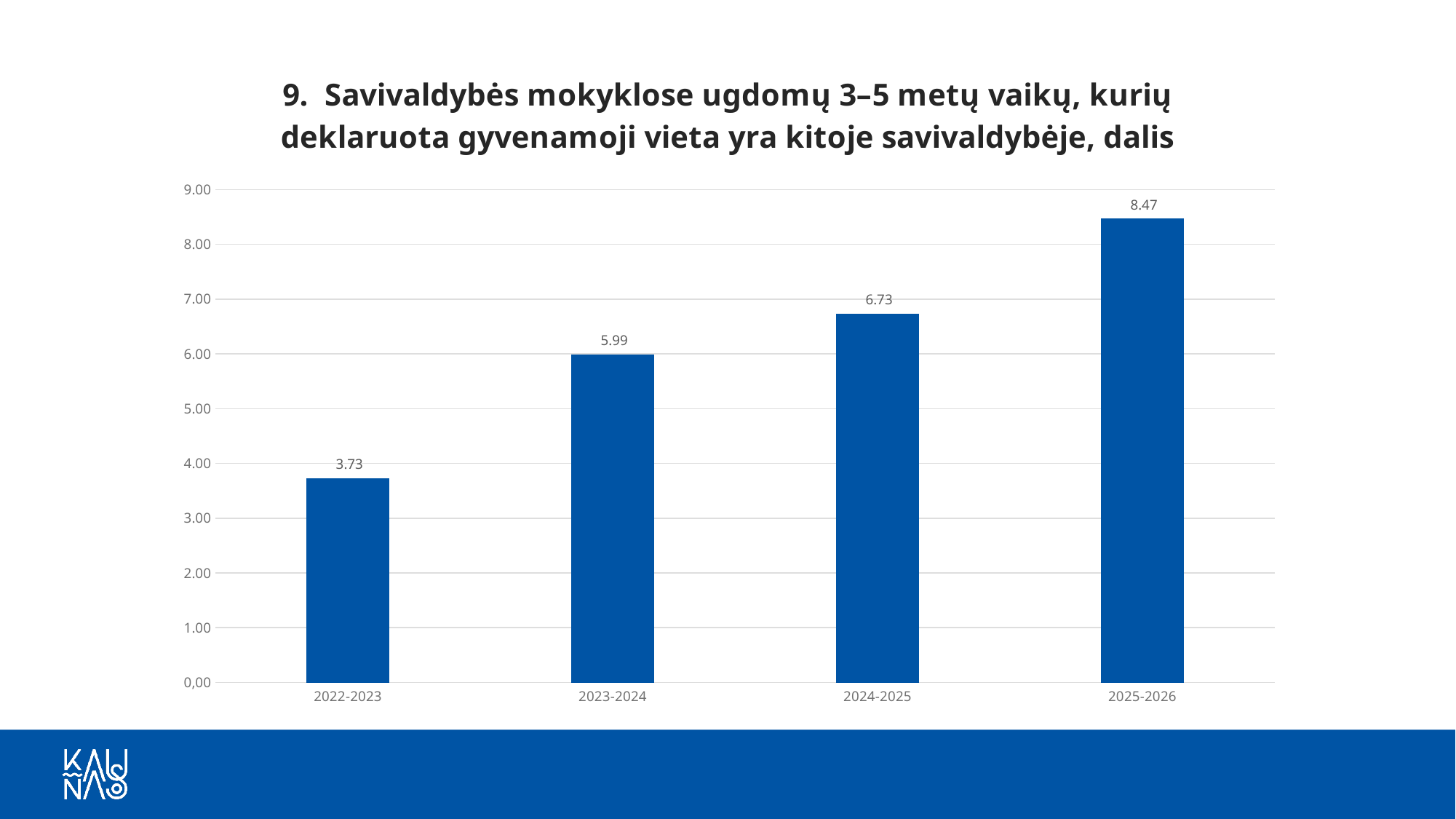
Which school year has the lowest value? 2022-2023 Which is larger, the value for 2023-2024 or the value for 2024-2025? 2024-2025 Which school year has the highest value? 2025-2026 How many school years are shown on the chart? 4 What is the difference between the values for 2025-2026 and 2022-2023? 4.74 What is the value for 2022-2023? 3.73 What kind of chart is shown on the slide? Bar chart What is the value for 2023-2024? 5.99 What is the difference between the values for 2024-2025 and 2023-2024? 0.74 What is the value for 2025-2026? 8.47 What is the value for 2024-2025? 6.73 Do the values rise or fall from 2022-2023 to 2025-2026? Rise